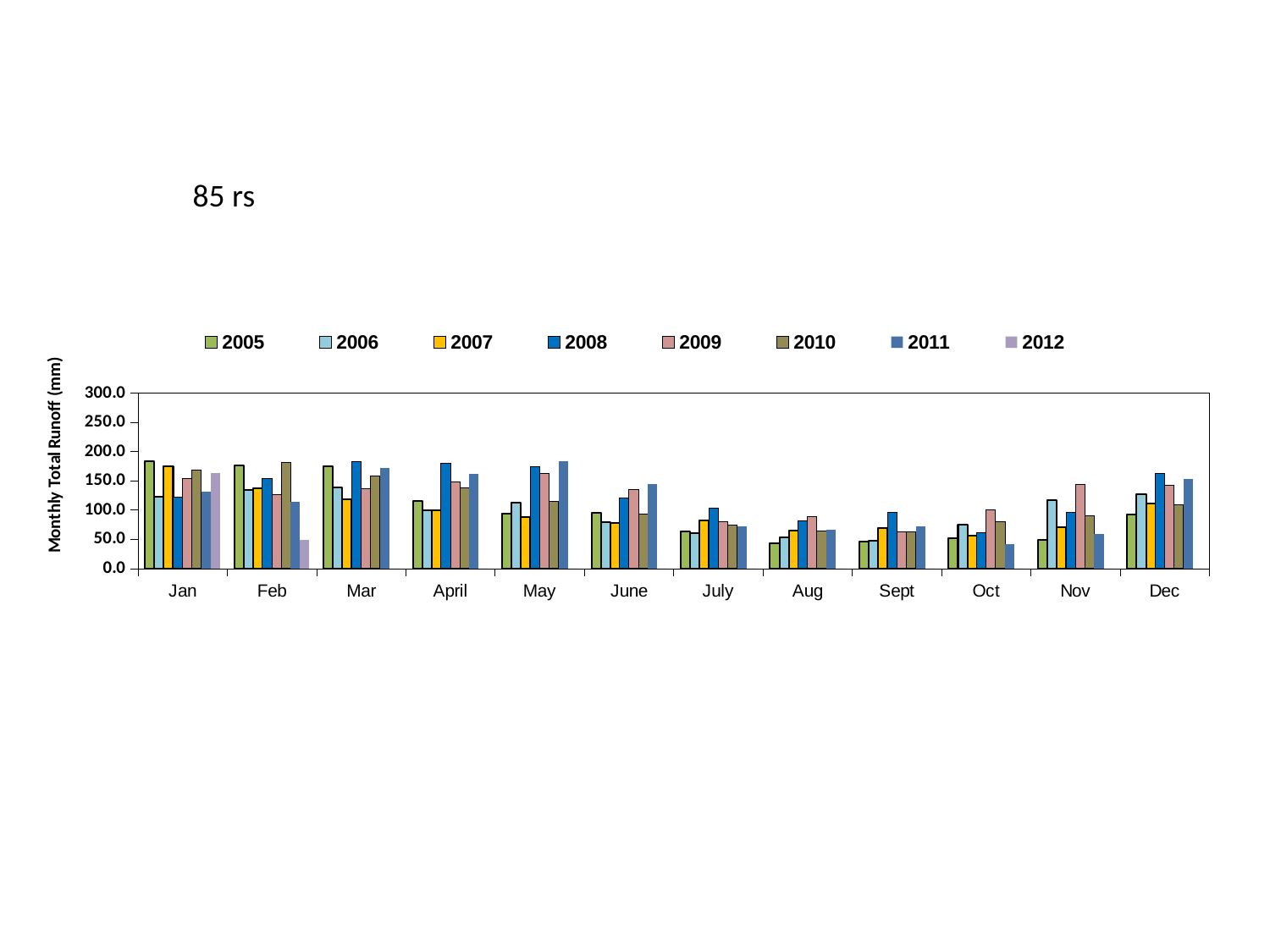
In Feb, which year has the lowest value? 2012 Is the value for 2011 in Oct greater or less than 50? less Is the value for 2005 in Aug greater or less than 50? less What is the y-axis title of the chart? Monthly Total Runoff (mm) How many series does the legend list? 8 In Nov, which year has the highest value? 2009 Is the value for 2009 in Nov greater or less than 100? greater In Jan, which is larger: the value for 2005 or the value for 2006? 2005 Which years are listed in the legend? 2005, 2006, 2007, 2008, 2009, 2010, 2011, 2012 What kind of chart is shown on the slide? bar chart How many months are shown along the x axis? 12